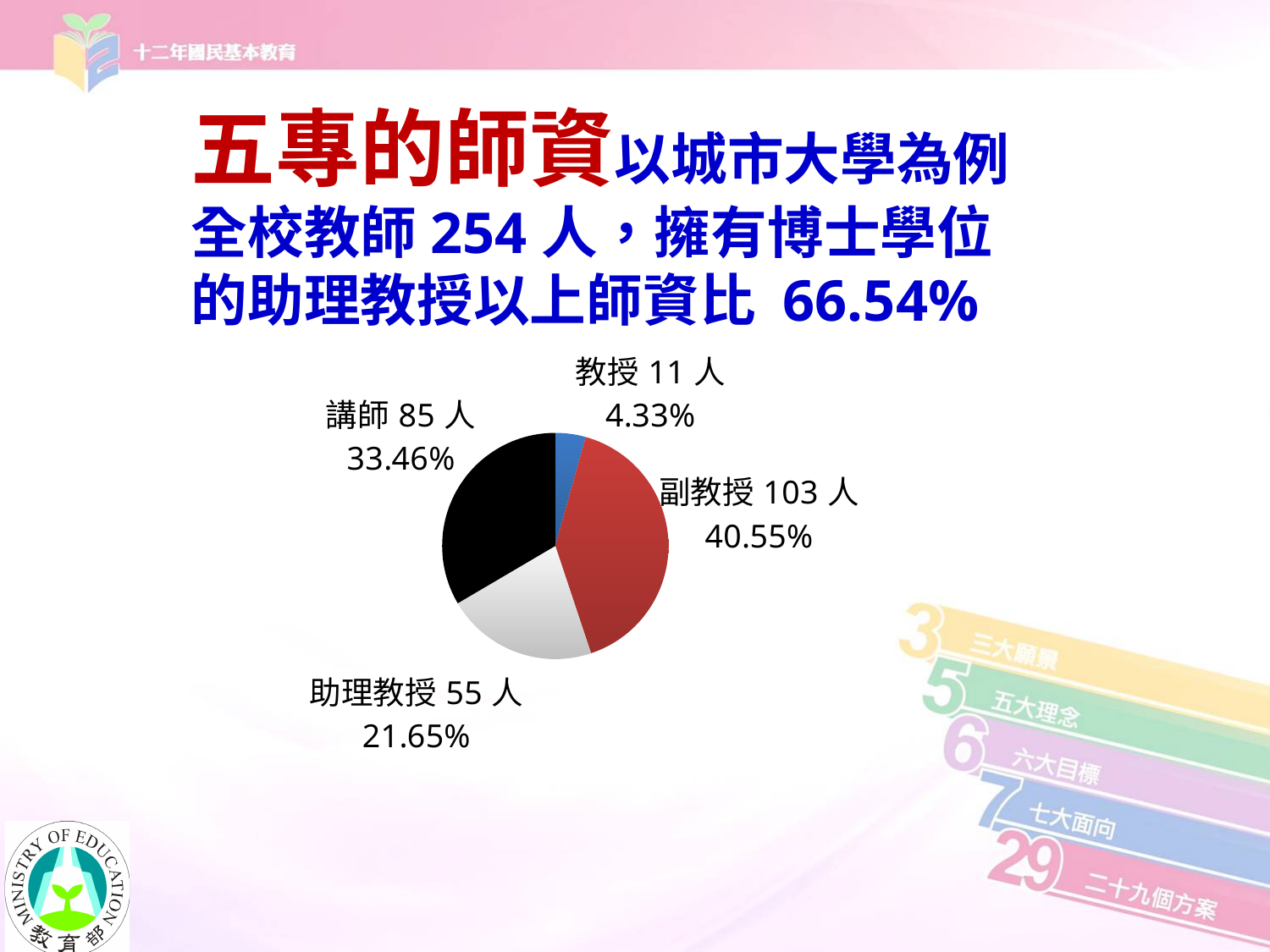
How many people are in the 助理教授 category? 55 人 What percentage share does the 講師 slice have? 33.46% How many people are in the 副教授 category? 103 人 What is the difference in headcount between 副教授 and 講師? 18 人 Which category has the largest slice of the pie? 副教授 Which category has the smallest slice of the pie? 教授 What is the total number of people across all four slices of the pie? 254 人 How many slices does the pie chart have? 4 What colour is the 副教授 slice of the pie? red What percentage share does the 教授 slice have? 4.33% Which category has more people, 講師 or 助理教授? 講師 What kind of chart is shown on the slide? pie chart